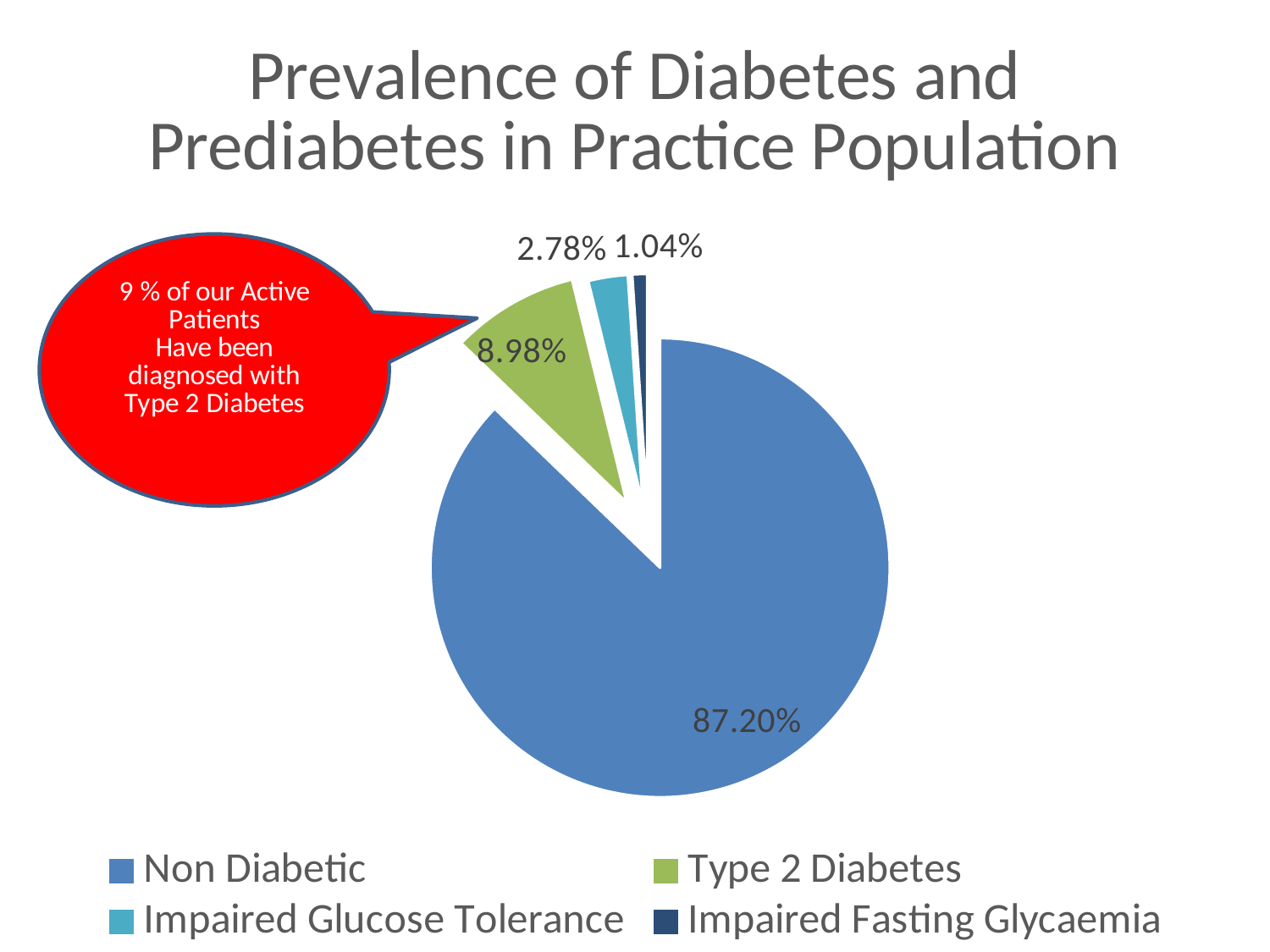
What share of the practice population has Impaired Glucose Tolerance? 2.78% What kind of chart is shown on the slide? pie chart What share of the practice population has Type 2 Diabetes? 8.98% Which is larger, the Type 2 Diabetes slice or the Impaired Glucose Tolerance slice? Type 2 Diabetes What colour is the Type 2 Diabetes slice? green What share of the practice population is Non Diabetic? 87.20% What share of the practice population has Impaired Fasting Glycaemia? 1.04% What is the title of the chart? Prevalence of Diabetes and Prediabetes in Practice Population What is the difference between the Type 2 Diabetes share and the Impaired Glucose Tolerance share? 6.20% Which category has the smallest slice of the pie? Impaired Fasting Glycaemia Which category has the largest slice of the pie? Non Diabetic How many categories does the pie chart show? 4